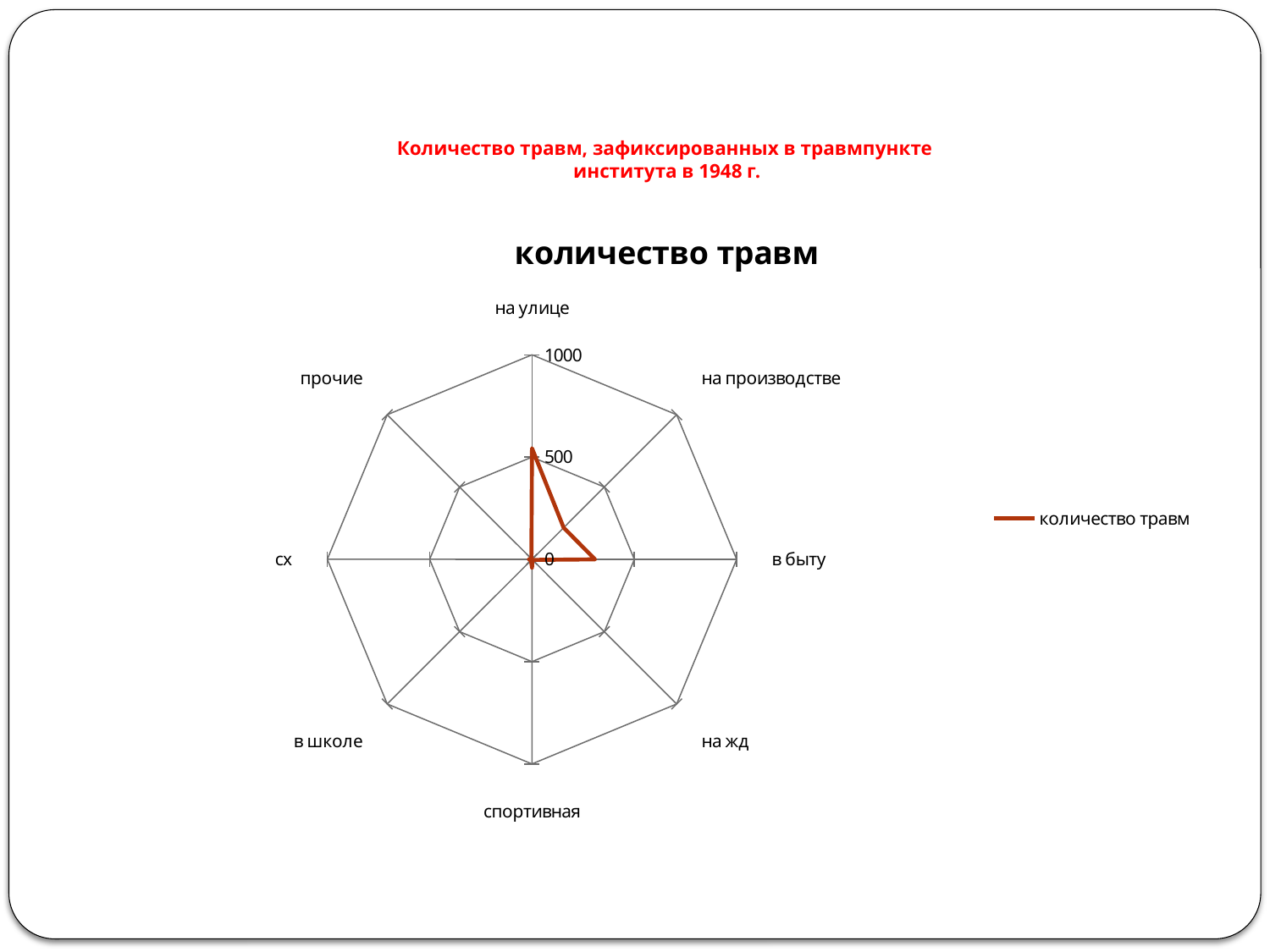
Is the value for в быту greater or less than 500? less Which is larger, the value for на улице or the value for в быту? на улице Which is larger, the value for в быту or the value for на производстве? в быту What is the title of the chart? количество травм How many categories (axes) does the radar chart have? 8 What kind of chart is shown on the slide? radar chart Which category has the highest value in the chart? на улице How many series does the legend list? 1 Is the value for на производстве greater or less than 500? less What is the name of the series shown in the legend? количество травм Is the value for на улице greater or less than 1000? less